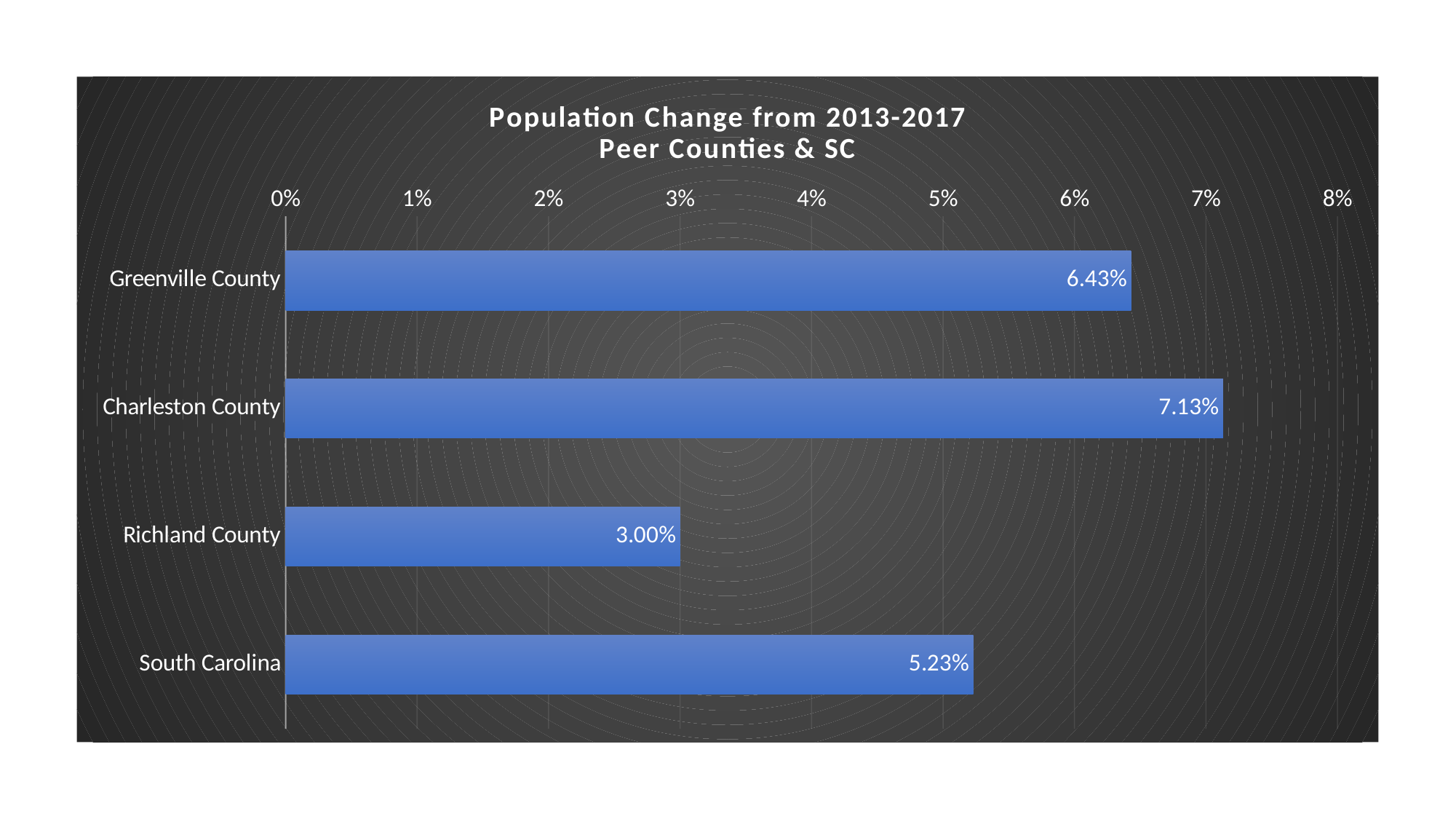
What is the population change for South Carolina? 5.23% What is the population change for Greenville County? 6.43% What is the population change for Charleston County? 7.13% Which category has the lowest population change? Richland County Is the value for Richland County greater or less than 4%? less Which category has the highest population change? Charleston County What is the population change for Richland County? 3.00% What kind of chart is shown on the slide? Bar chart What is the difference between the population change for South Carolina and Richland County? 2.23% Which has a larger population change, Greenville County or South Carolina? Greenville County How many categories are shown in the chart? 4 What is the difference between the population change for Charleston County and Greenville County? 0.70%